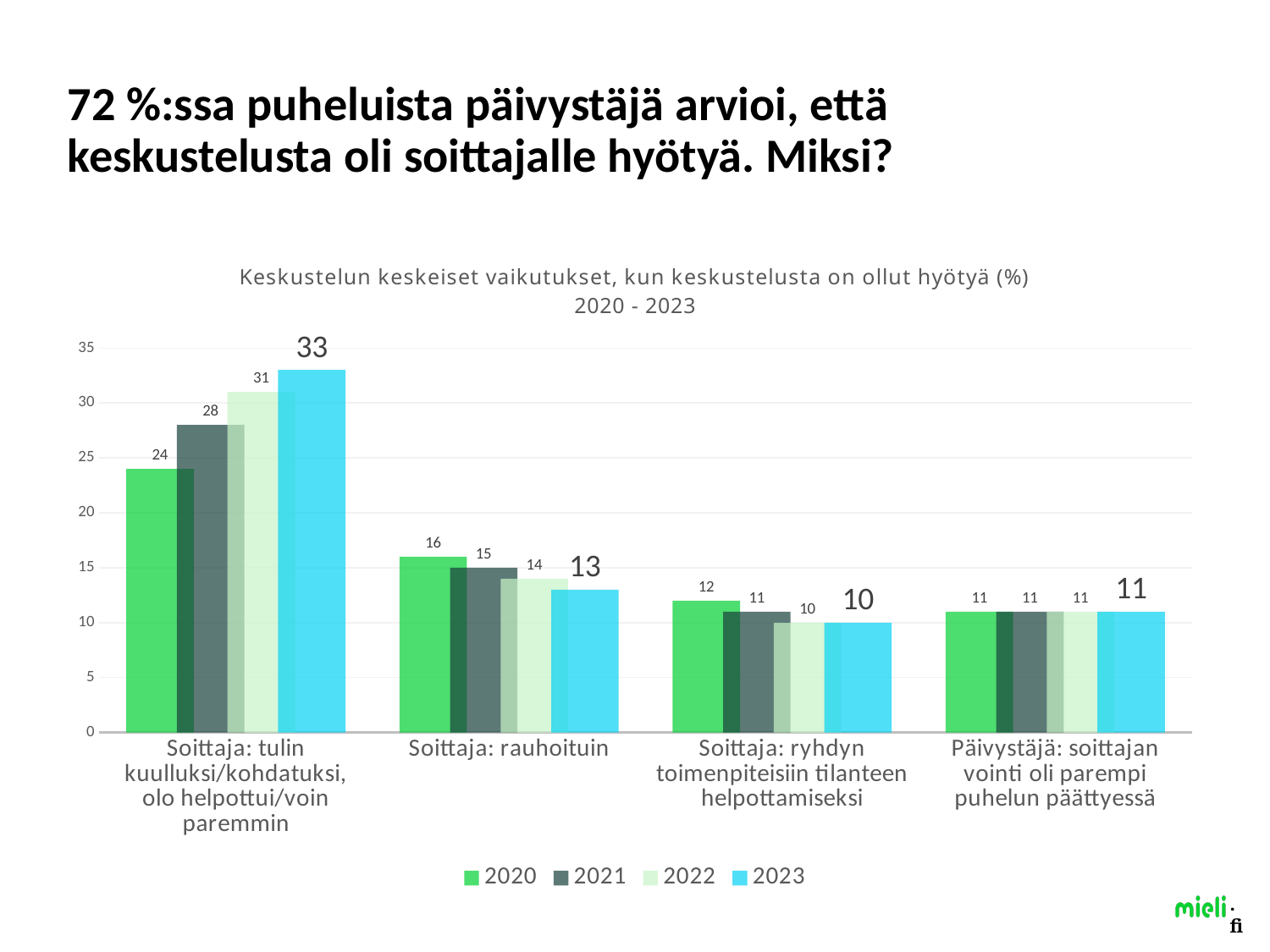
Do the values for "Soittaja: rauhoituin" rise or fall from 2020 to 2023? Fall What kind of chart is shown on the slide? Bar chart How many categories are shown on the x axis? 4 Which category has the highest 2023 value? Soittaja: tulin kuulluksi/kohdatuksi, olo helpottui/voin paremmin What is the 2020 value for "Soittaja: rauhoituin"? 16 How many series does the legend list? 4 What is the 2021 value for "Päivystäjä: soittajan vointi oli parempi puhelun päättyessä"? 11 What is the 2023 value for "Soittaja: tulin kuulluksi/kohdatuksi, olo helpottui/voin paremmin"? 33 Which is larger for "Soittaja: rauhoituin": the 2020 value or the 2023 value? 2020 What is the 2022 value for "Soittaja: ryhdyn toimenpiteisiin tilanteen helpottamiseksi"? 10 Which category has the lowest 2020 value? Päivystäjä: soittajan vointi oli parempi puhelun päättyessä What is the difference between the 2023 and 2020 values for "Soittaja: tulin kuulluksi/kohdatuksi, olo helpottui/voin paremmin"? 9